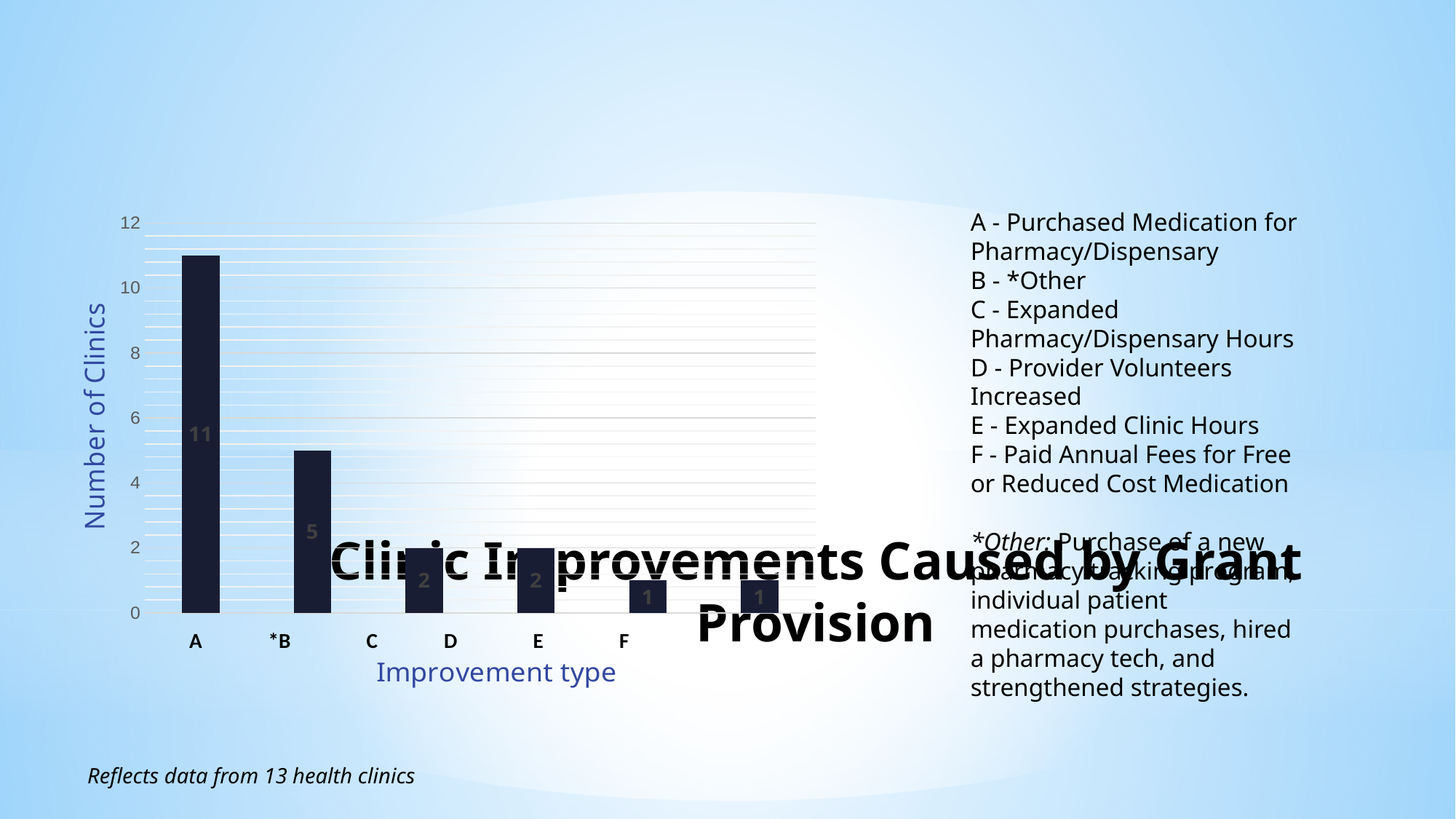
What is the number of clinics for improvement type *B? 5 What is the number of clinics for improvement type C? 2 What is the difference in number of clinics between improvement type A and improvement type *B? 6 What kind of chart is shown on the slide? bar chart What is the number of clinics for improvement type F? 1 What is the label of the vertical axis? Number of Clinics How many improvement types are plotted on the chart? 6 What is the number of clinics for improvement type A? 11 Do the values rise or fall moving from A to F along the x axis? fall Which has more clinics, improvement type *B or improvement type E? *B Which improvement type has the highest number of clinics? A Is the value for improvement type A greater or less than 10? greater